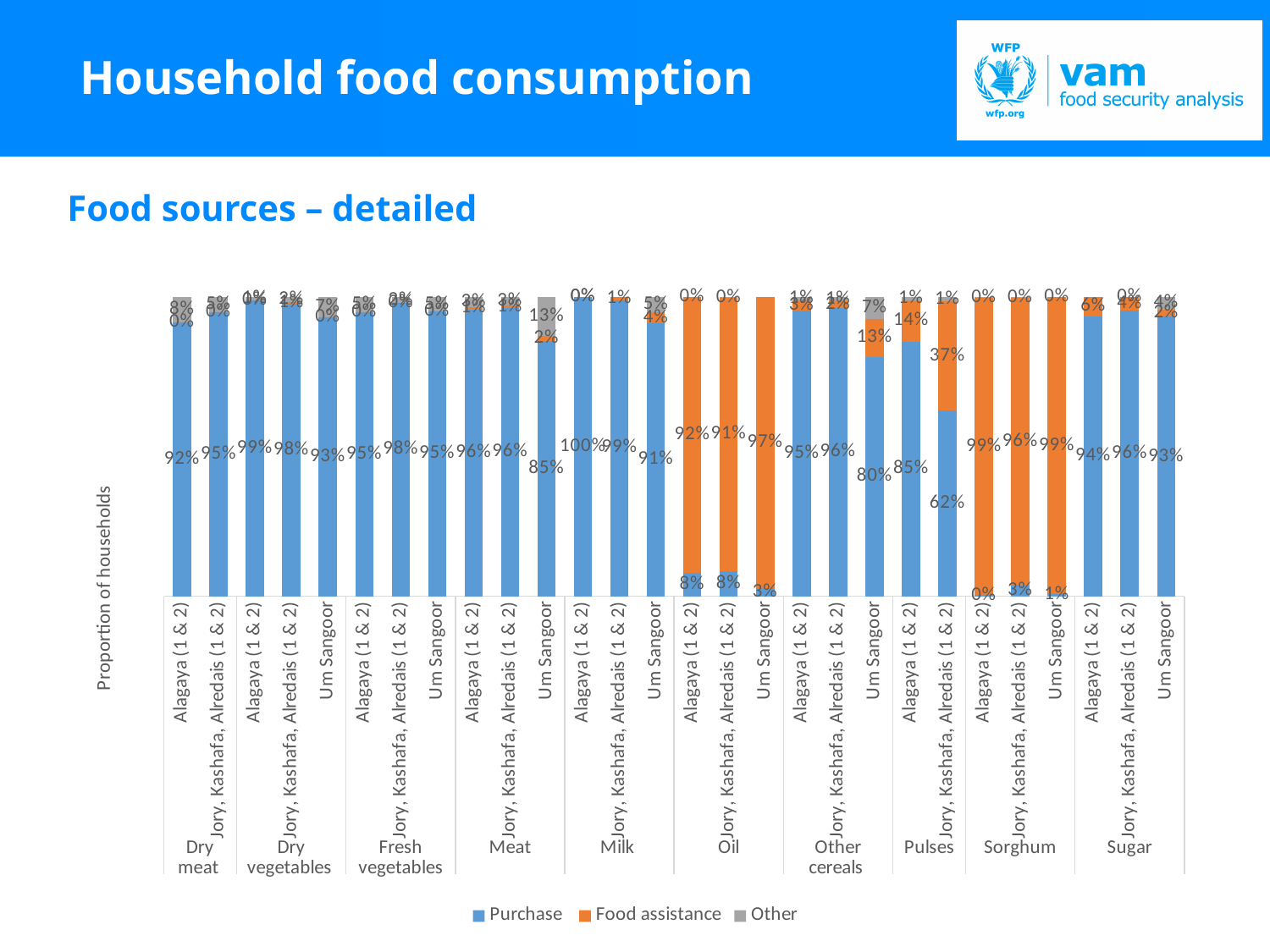
What type of chart is shown on the slide? Stacked bar chart How many series does the legend list? 3 Under Pulses, which is larger: the Food assistance value for Alagaya (1 & 2) or for Jory, Kashafa, Alredais (1 & 2)? Jory, Kashafa, Alredais (1 & 2) What is the Other value for Um Sangoor under Other cereals? 7% What is the Purchase value for Jory, Kashafa, Alredais (1 & 2) under Pulses? 62% Which location has the highest Purchase value under Milk? Alagaya (1 & 2) What is the difference between the Purchase values for Um Sangoor under Other cereals and under Sugar? 13% What is the Food assistance value for Alagaya (1 & 2) under Oil? 92% What is the label of the y axis? Proportion of households What is the Purchase value for Um Sangoor under Meat? 85% Which location has the lowest Purchase value under Oil? Um Sangoor What is the Food assistance value for Um Sangoor under Sorghum? 99%